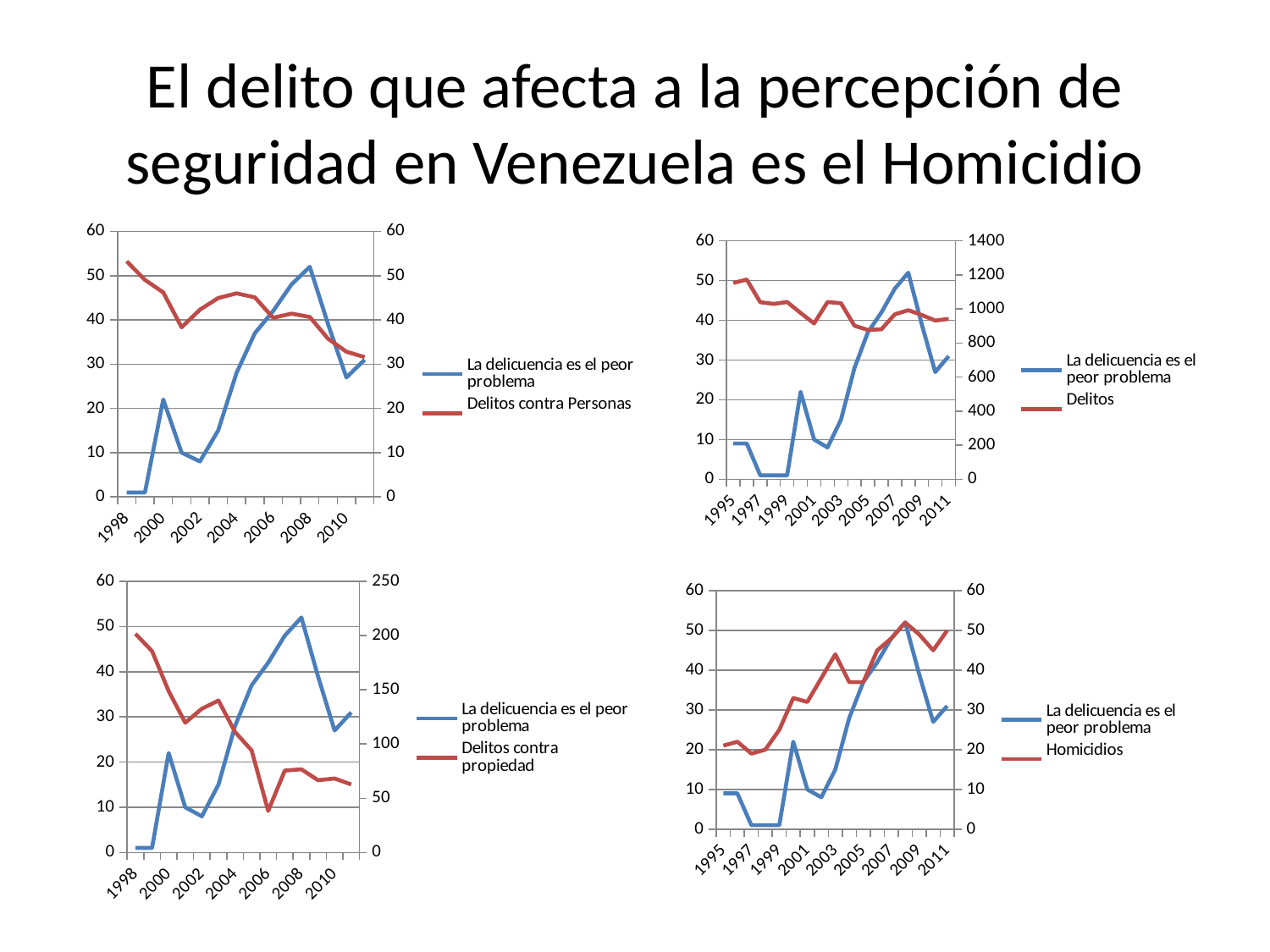
In the bottom-left chart, what is the name of the red series in the legend? Delitos contra propiedad In the bottom-right chart, does the 'Homicidios' series generally rise or fall from 1995 to 2011? rise In the bottom-right chart, is the value of 'Homicidios' in 2003 greater or less than 40? greater In the bottom-left chart, is the value of 'Delitos contra propiedad' in 2006 (right axis) greater or less than 50? less What kind of chart is the top-left chart with the legend entry 'Delitos contra Personas'? line chart How many series does the legend of the bottom-right chart (with 'Homicidios') list? 2 In the top-right chart, is the value of 'Delitos' in 1995 (right axis) greater or less than 1000? greater In the bottom-right chart, which series has the larger value in 2001: 'Homicidios' or 'La delicuencia es el peor problema'? Homicidios In the top-right chart, what is the name of the red series in the legend? Delitos In the top-left chart, does the 'Delitos contra Personas' series generally rise or fall from 1998 to 2011? fall